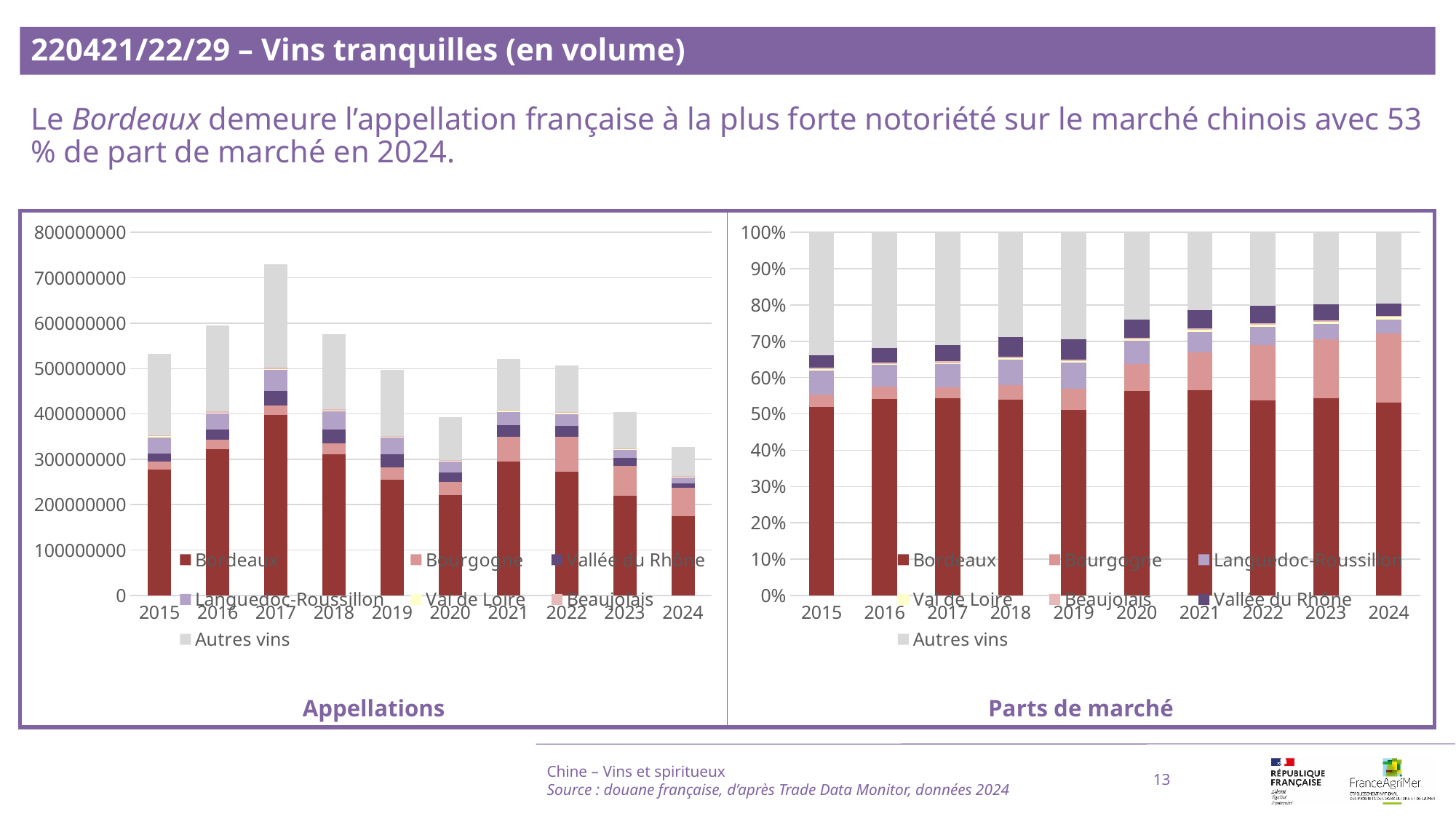
What colour represents 'Autres vins' in the legend of the 'Parts de marché' chart? Grey In the 'Appellations' chart, which year has the highest total bar? 2017 In the 'Appellations' chart, is the total bar for 2017 greater or less than 700000000? greater In the 'Appellations' chart, is the total bar for 2024 greater or less than 400000000? less How many years are shown on the x axis of the 'Parts de marché' chart? 10 In the 'Parts de marché' chart, is the Bordeaux share for 2024 greater or less than 40%? greater In the 'Appellations' chart, which year has the lowest total bar? 2024 In the 'Appellations' chart, do the total bars rise or fall from 2021 to 2024? fall How many series does the legend of the 'Appellations' chart list? 7 In the 'Appellations' chart, which total bar is larger, 2017 or 2024? 2017 What kind of chart is the 'Appellations' chart on the left? Stacked bar chart